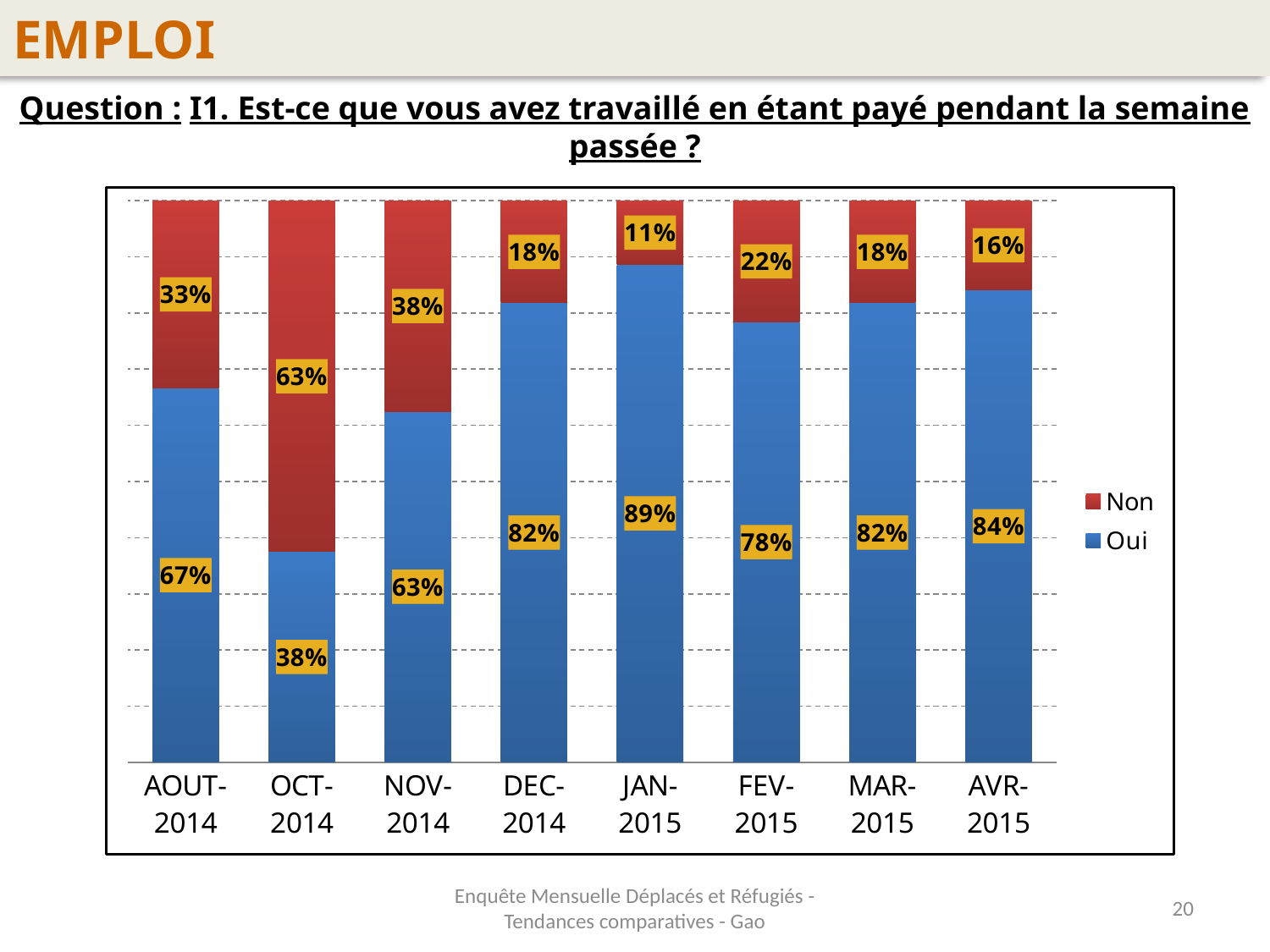
Which colour represents the 'Non' series? Red Which month has the highest 'Non' value? OCT-2014 What is the difference between the 'Oui' values for JAN-2015 and FEV-2015? 11% Which month has the highest 'Oui' value? JAN-2015 What is the 'Non' value for FEV-2015? 22% What is the 'Oui' value for OCT-2014? 38% How many months are shown on the x axis? 8 What kind of chart is shown on the slide? Stacked bar chart What is the 'Oui' value for JAN-2015? 89% Which is larger, the 'Oui' value for AOUT-2014 or for NOV-2014? AOUT-2014 Which month has the lowest 'Oui' value? OCT-2014 How many series does the legend list? 2